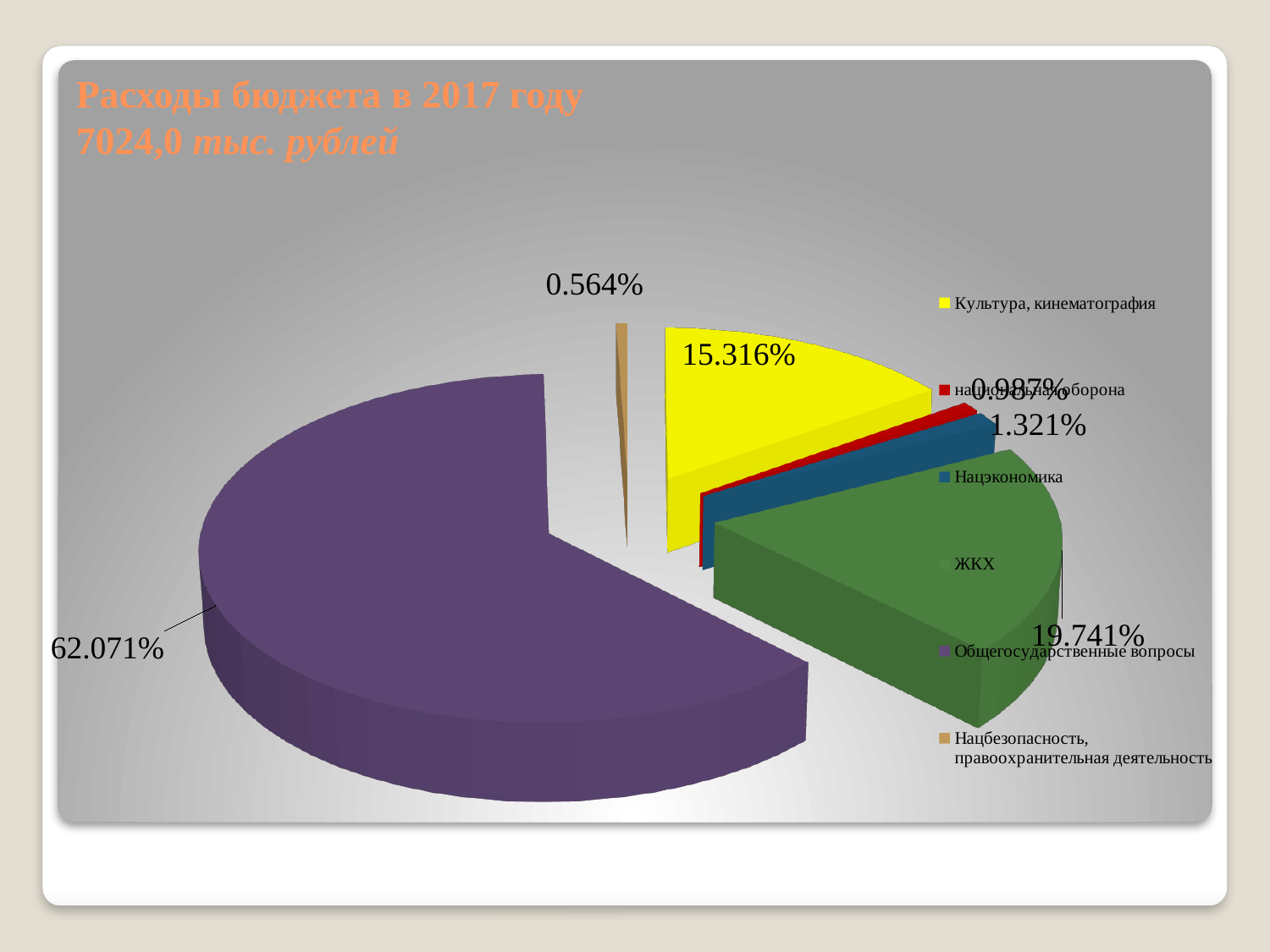
What percentage is shown for Культура, кинематография? 15.316% Which category has the largest share of the pie? Общегосударственные вопросы What is the title of the chart? Расходы бюджета в 2017 году 7024,0 тыс. рублей Which is larger, the share for ЖКХ or the share for Культура, кинематография? ЖКХ What percentage is shown for Нацэкономика? 1.321% What percentage is shown for Нацбезопасность, правоохранительная деятельность? 0.564% What share of the budget expenses goes to Общегосударственные вопросы? 62.071% Which category has the smallest share of the pie? Нацбезопасность, правоохранительная деятельность What percentage is shown for ЖКХ? 19.741% What kind of chart is shown on the slide? pie chart What is the difference between the share for Общегосударственные вопросы and the share for ЖКХ? 42.330% How many categories does the legend list? 6